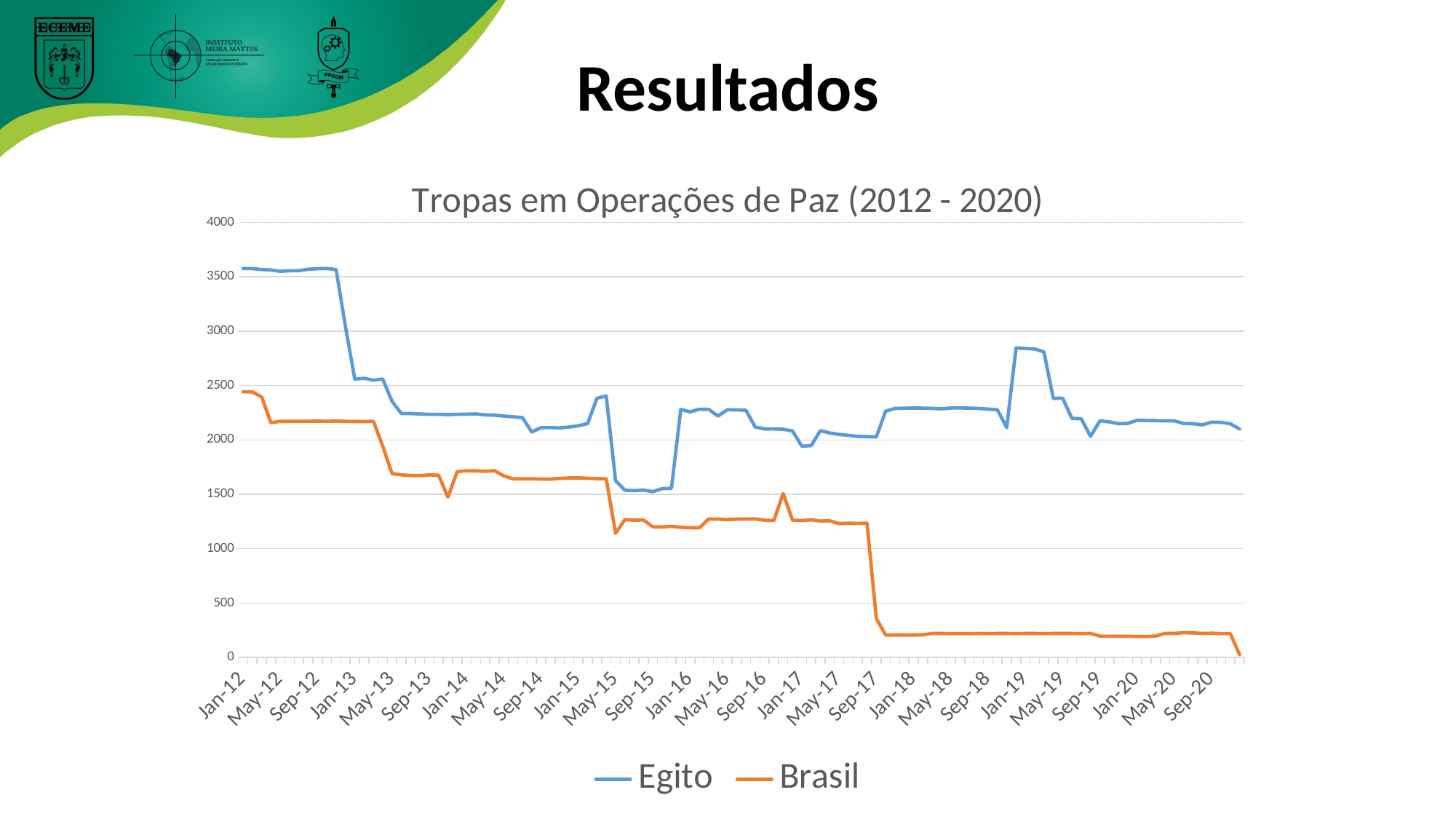
Which series is drawn in orange? Brasil Is the value for Egito at Sep-15 greater or less than 2000? less Which series has the larger value at Jan-18, Egito or Brasil? Egito How many series does the legend list? 2 How many labels are shown on the x axis? 27 Is the value for Brasil at Jan-16 greater or less than 1000? greater What kind of chart is shown on the slide? line chart What is the title of the chart? Tropas em Operações de Paz (2012 - 2020) Is the value for Egito at Jan-19 greater or less than 2500? greater Does the Brasil series overall rise or fall from Jan-12 to Sep-20? fall